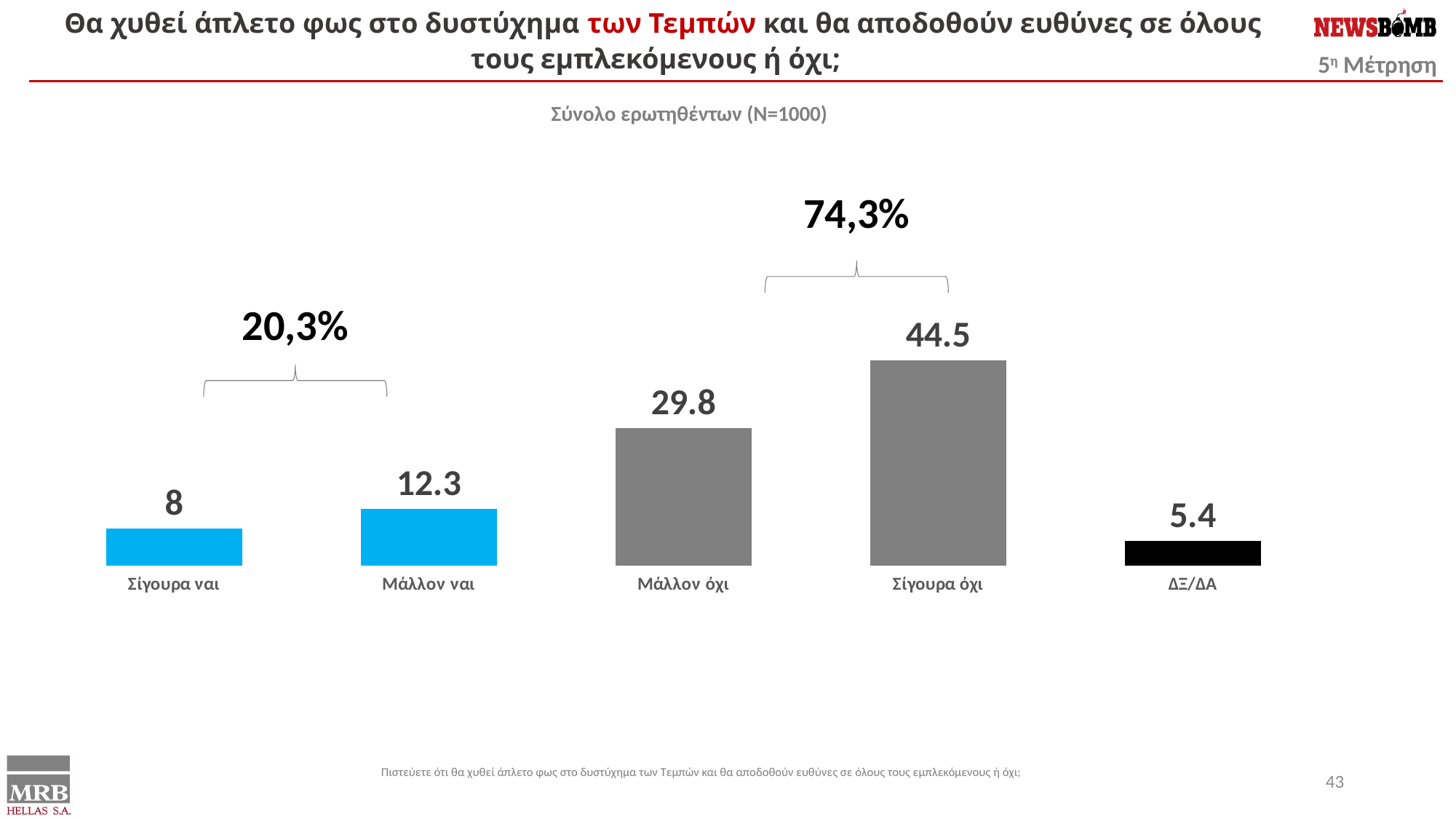
What kind of chart is shown on the slide? Bar chart What combined percentage is shown above the bracket grouping Μάλλον όχι and Σίγουρα όχι? 74,3% What is the difference between the values for Σίγουρα όχι and Μάλλον όχι? 14.7 What is the value for Σίγουρα όχι? 44.5 What is the value for ΔΞ/ΔΑ? 5.4 How many categories are shown in the chart? 5 Which category has the highest value? Σίγουρα όχι What is the value for Μάλλον ναι? 12.3 Which category has the lowest value? ΔΞ/ΔΑ What is the value for Μάλλον όχι? 29.8 What is the value for Σίγουρα ναι? 8 Which is larger, the value for Μάλλον ναι or the value for Σίγουρα ναι? Μάλλον ναι